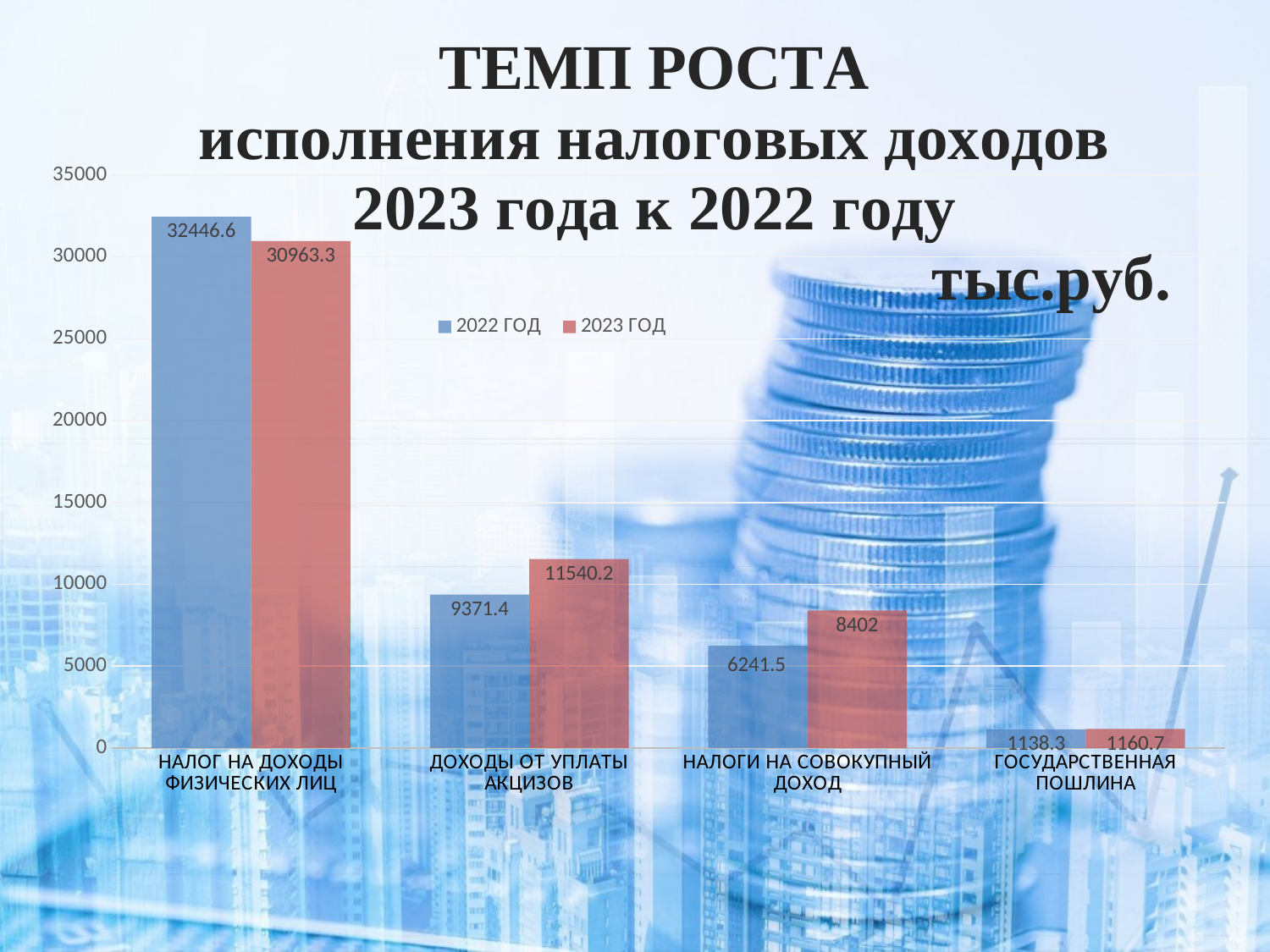
What is the 2023 ГОД value for НАЛОГИ НА СОВОКУПНЫЙ ДОХОД? 8402 What is the difference between the 2022 ГОД and 2023 ГОД values for НАЛОГ НА ДОХОДЫ ФИЗИЧЕСКИХ ЛИЦ? 1483.3 How many categories are shown on the x axis? 4 What kind of chart is shown on the slide? Bar chart Which category has the highest 2023 ГОД value? НАЛОГ НА ДОХОДЫ ФИЗИЧЕСКИХ ЛИЦ Which category has the lowest 2022 ГОД value? ГОСУДАРСТВЕННАЯ ПОШЛИНА What is the 2022 ГОД value for ГОСУДАРСТВЕННАЯ ПОШЛИНА? 1138.3 How many series does the legend list? 2 What is the 2022 ГОД value for НАЛОГ НА ДОХОДЫ ФИЗИЧЕСКИХ ЛИЦ? 32446.6 For НАЛОГИ НА СОВОКУПНЫЙ ДОХОД, which is larger: the 2022 ГОД value or the 2023 ГОД value? 2023 ГОД What is the 2023 ГОД value for ДОХОДЫ ОТ УПЛАТЫ АКЦИЗОВ? 11540.2 What is the difference between the 2023 ГОД and 2022 ГОД values for ДОХОДЫ ОТ УПЛАТЫ АКЦИЗОВ? 2168.8